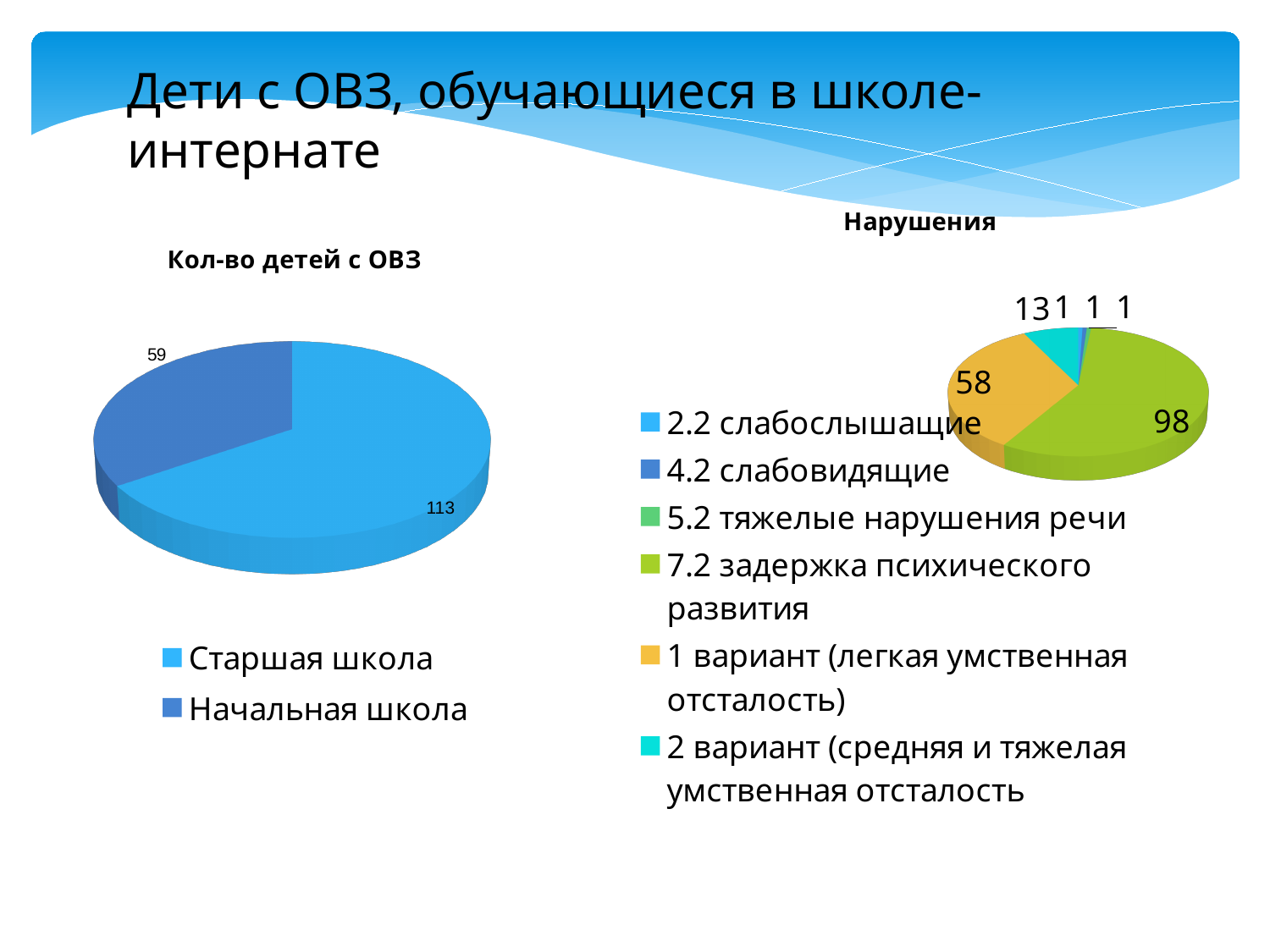
On the chart titled "Кол-во детей с ОВЗ", what is the value for Старшая школа? 113 On the chart titled "Кол-во детей с ОВЗ", which category has the larger value? Старшая школа On the chart titled "Нарушения", how many categories does the legend list? 6 What kind of chart is the chart titled "Кол-во детей с ОВЗ"? Pie chart On the chart titled "Кол-во детей с ОВЗ", what is the value for Начальная школа? 59 On the chart titled "Кол-во детей с ОВЗ", what is the difference between Старшая школа and Начальная школа? 54 On the chart titled "Нарушения", what is the value for 2 вариант (средняя и тяжелая умственная отсталость)? 13 On the chart titled "Нарушения", what is the value for 7.2 задержка психического развития? 98 On the chart titled "Нарушения", which category has the largest slice? 7.2 задержка психического развития On the chart titled "Нарушения", what is the difference between the values for 7.2 задержка психического развития and 1 вариант (легкая умственная отсталость)? 40 On the chart titled "Нарушения", what is the value for 1 вариант (легкая умственная отсталость)? 58 On the chart titled "Кол-во детей с ОВЗ", how many categories does the legend list? 2